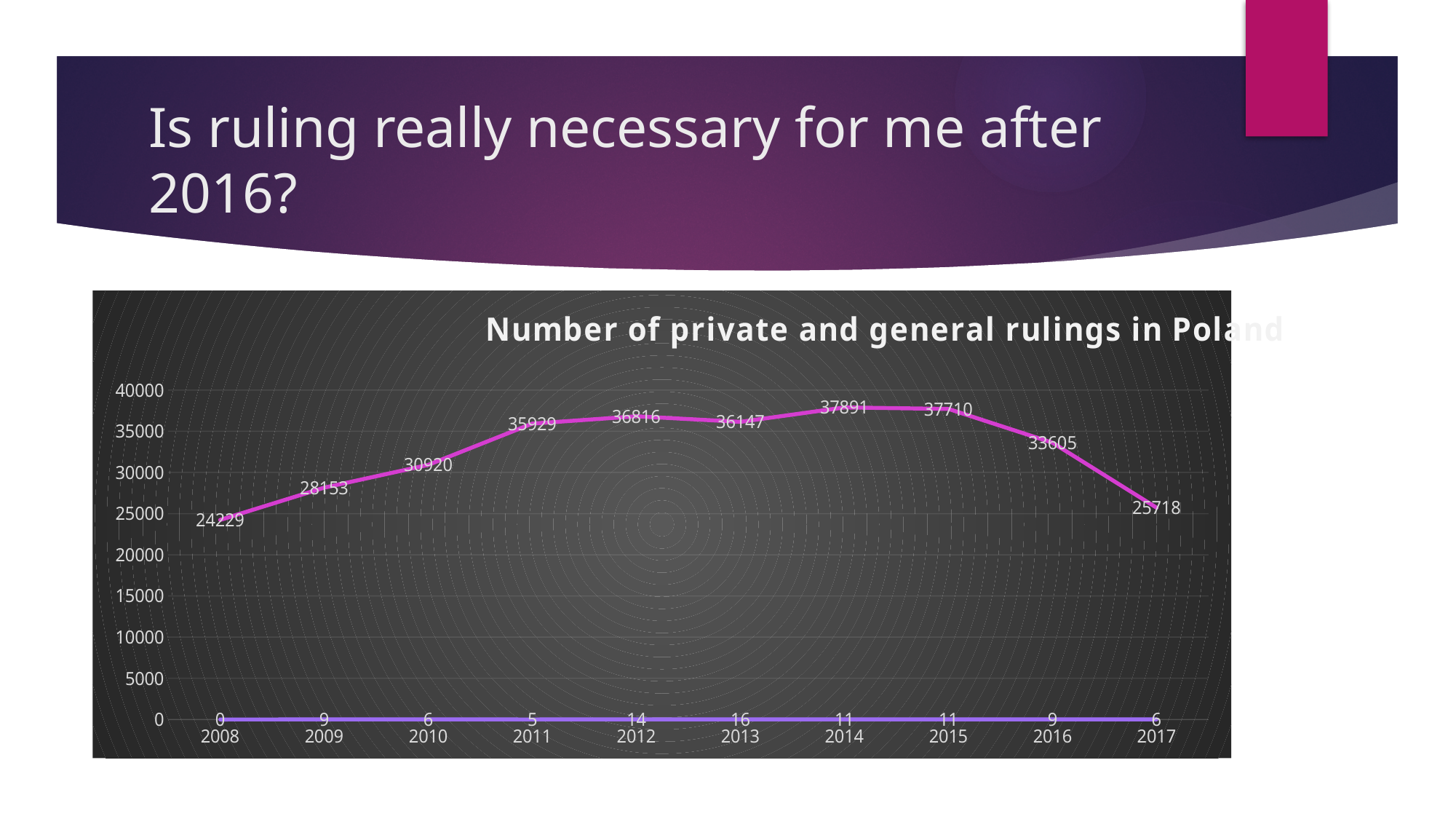
What is the value of the upper (magenta) line in 2017? 25718 In which year does the upper (magenta) line reach its highest value? 2014 What type of chart is shown on the slide? line chart What is the value of the lower (blue) line in 2013? 16 What is the value of the upper (magenta) line in 2008? 24229 What is the difference between the upper line's values in 2014 and 2017? 12173 Which year has the larger value on the upper (magenta) line, 2011 or 2016? 2011 In which year does the upper (magenta) line have its lowest value? 2008 What is the value of the upper (magenta) line in 2012? 36816 What is the title of the chart? Number of private and general rulings in Poland How many years are plotted along the x axis of the chart? 10 Does the upper (magenta) line rise or fall between 2015 and 2017? fall